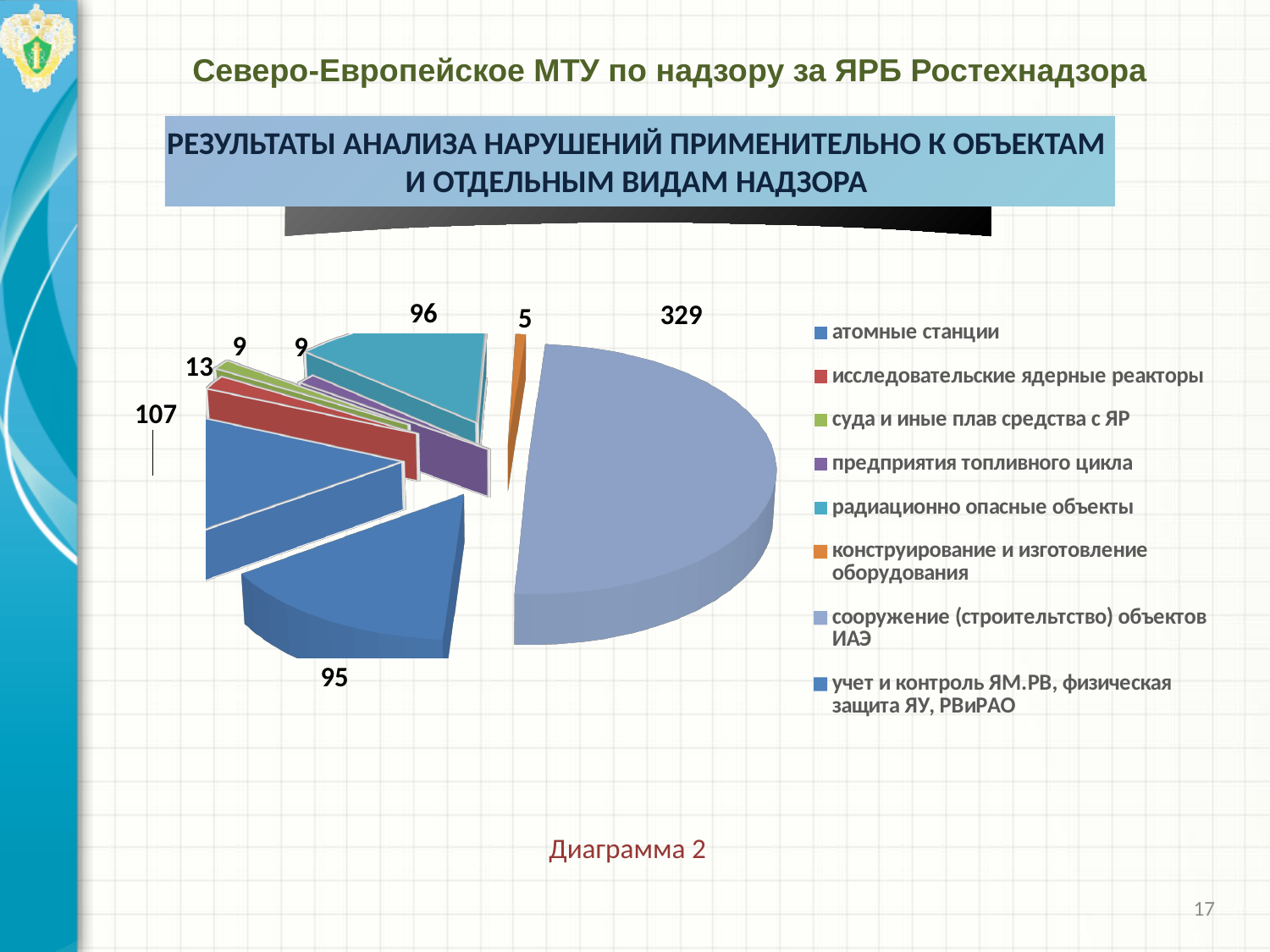
What is the value for конструирование и изготовление оборудования? 5 Which category has the largest slice of the pie? сооружение (строительство) объектов ИАЭ What is the value for радиационно опасные объекты? 96 What is the value for сооружение (строительство) объектов ИАЭ? 329 What is the value for исследовательские ядерные реакторы? 13 What type of chart is shown on the slide? pie chart Which category has the smallest slice of the pie? конструирование и изготовление оборудования What caption is shown below the chart? Диаграмма 2 How many categories does the pie chart have? 8 Which is larger: the value for атомные станции or the value for учет и контроль ЯМ.РВ, физическая защита ЯУ, РВиРАО? атомные станции What is the difference between the values for сооружение (строительство) объектов ИАЭ and атомные станции? 222 What is the value for атомные станции? 107